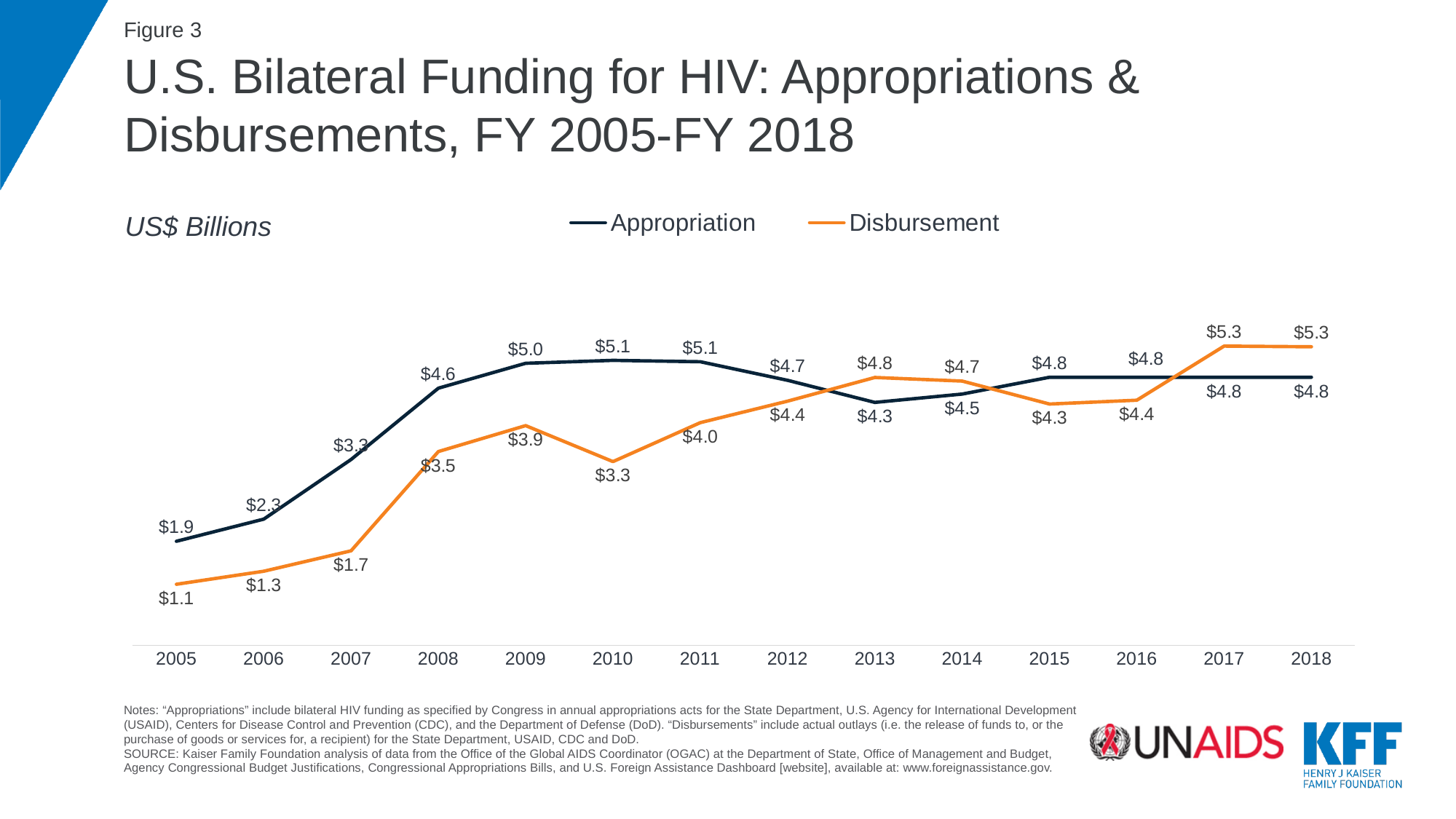
What kind of chart is shown on the slide? Line chart Which was larger in 2017, Appropriation or Disbursement? Disbursement What was the Disbursement value in 2010? $3.3 What was the Disbursement value in 2005? $1.1 How many years are shown on the x axis? 14 In which year was Disbursement lowest? 2005 What is the difference between Appropriation and Disbursement in 2008? $1.1 How many series does the legend list? 2 What was the Appropriation value in 2009? $5.0 Which was larger in 2011, Appropriation or Disbursement? Appropriation What was the Appropriation value in 2013? $4.3 What is the highest Disbursement value shown on the chart? $5.3